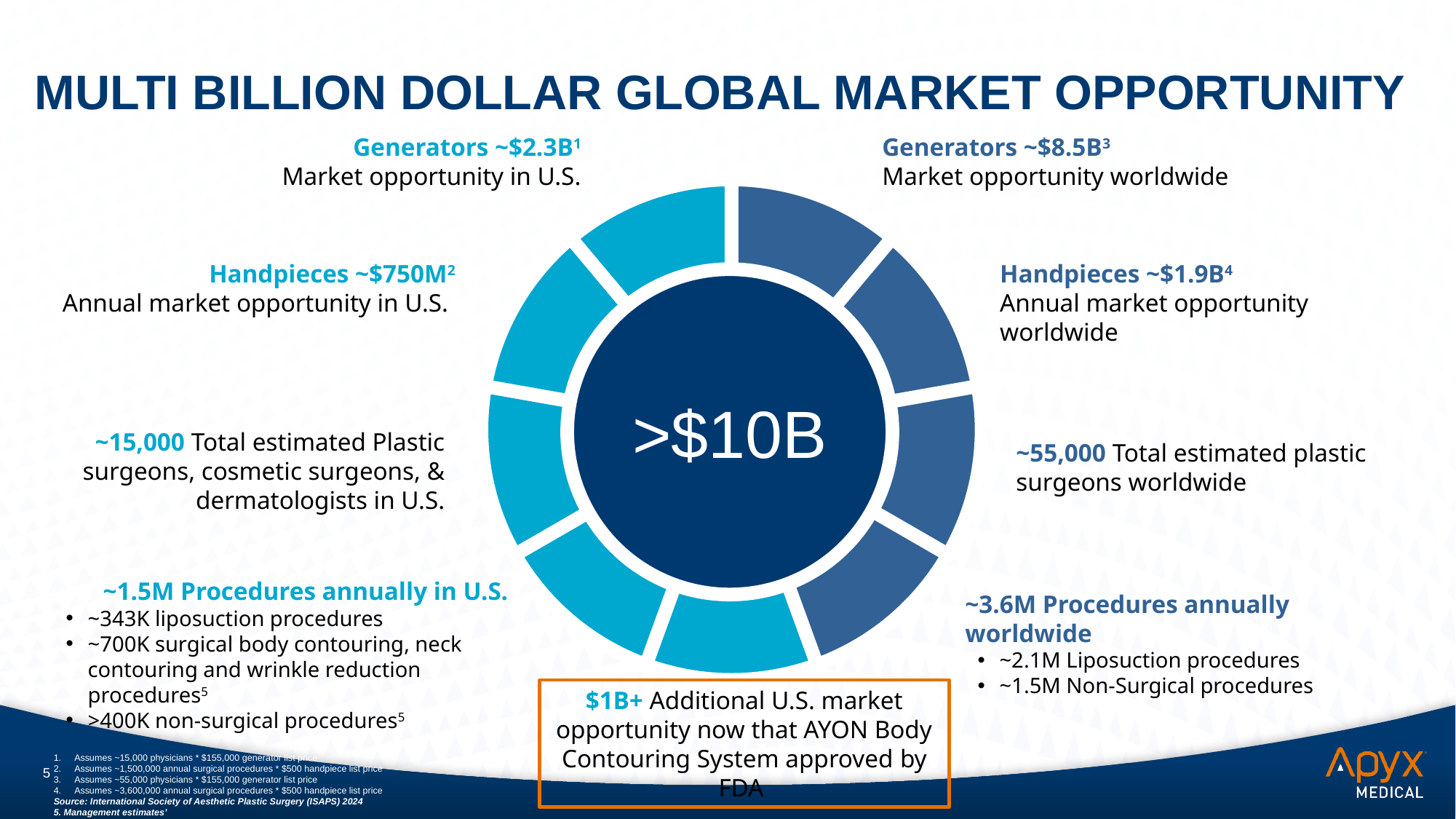
What kind of chart is shown on the slide? donut chart Which is larger, the generators market opportunity in the U.S. or worldwide? worldwide Which is larger, the annual handpieces market opportunity in the U.S. or worldwide? worldwide How many segments does the donut chart have? 9 What is the generators market opportunity in the U.S. shown on the left of the chart? ~$2.3B What is the annual handpieces market opportunity in the U.S.? ~$750M What value is shown in the centre of the donut chart? >$10B What is the generators market opportunity worldwide shown on the right of the chart? ~$8.5B What is the title of the slide containing the donut chart? MULTI BILLION DOLLAR GLOBAL MARKET OPPORTUNITY What colour are the donut segments on the left (U.S.) side of the chart? light blue How many procedures annually are shown for the U.S. side of the chart? ~1.5M What is the annual handpieces market opportunity worldwide? ~$1.9B